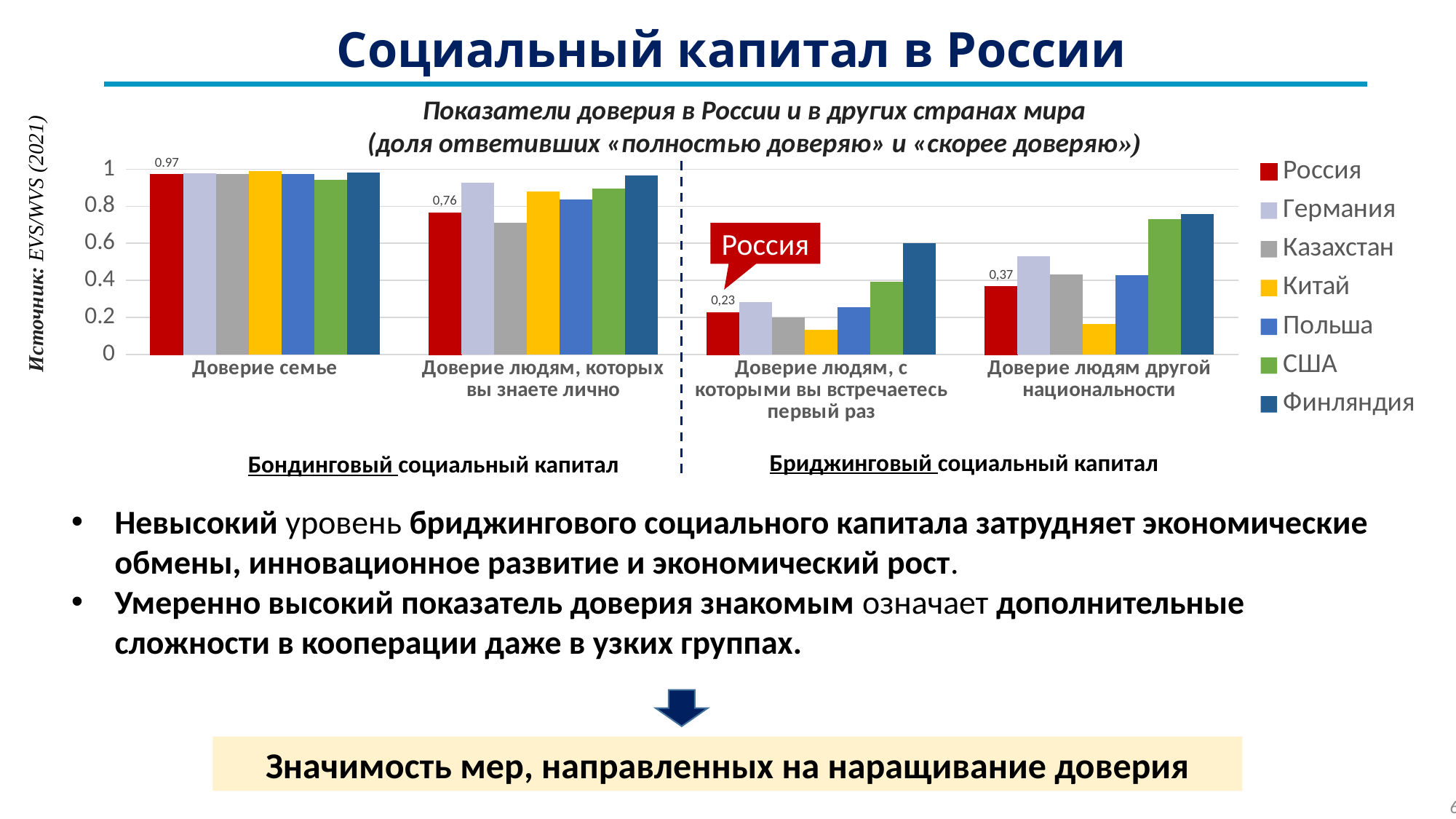
What is the value for Россия in the category «Доверие семье»? 0.97 In the category «Доверие людям, с которыми вы встречаетесь первый раз», which country has the lowest value? Китай How many categories are shown on the x axis of the chart? 4 What is the value for Россия in the category «Доверие людям, с которыми вы встречаетесь первый раз»? 0,23 In the category «Доверие людям другой национальности», which is larger: the value for Россия or the value for Германия? Германия In the category «Доверие людям, с которыми вы встречаетесь первый раз», which country has the highest value? Финляндия What is the value for Россия in the category «Доверие людям другой национальности»? 0,37 Is the value for Финляндия in the category «Доверие людям другой национальности» greater or less than 0.6? greater How many countries (series) does the legend list? 7 What kind of chart is shown on the slide? Bar chart What is the value for Россия in the category «Доверие людям, которых вы знаете лично»? 0,76 Which country is shown in red in the legend? Россия